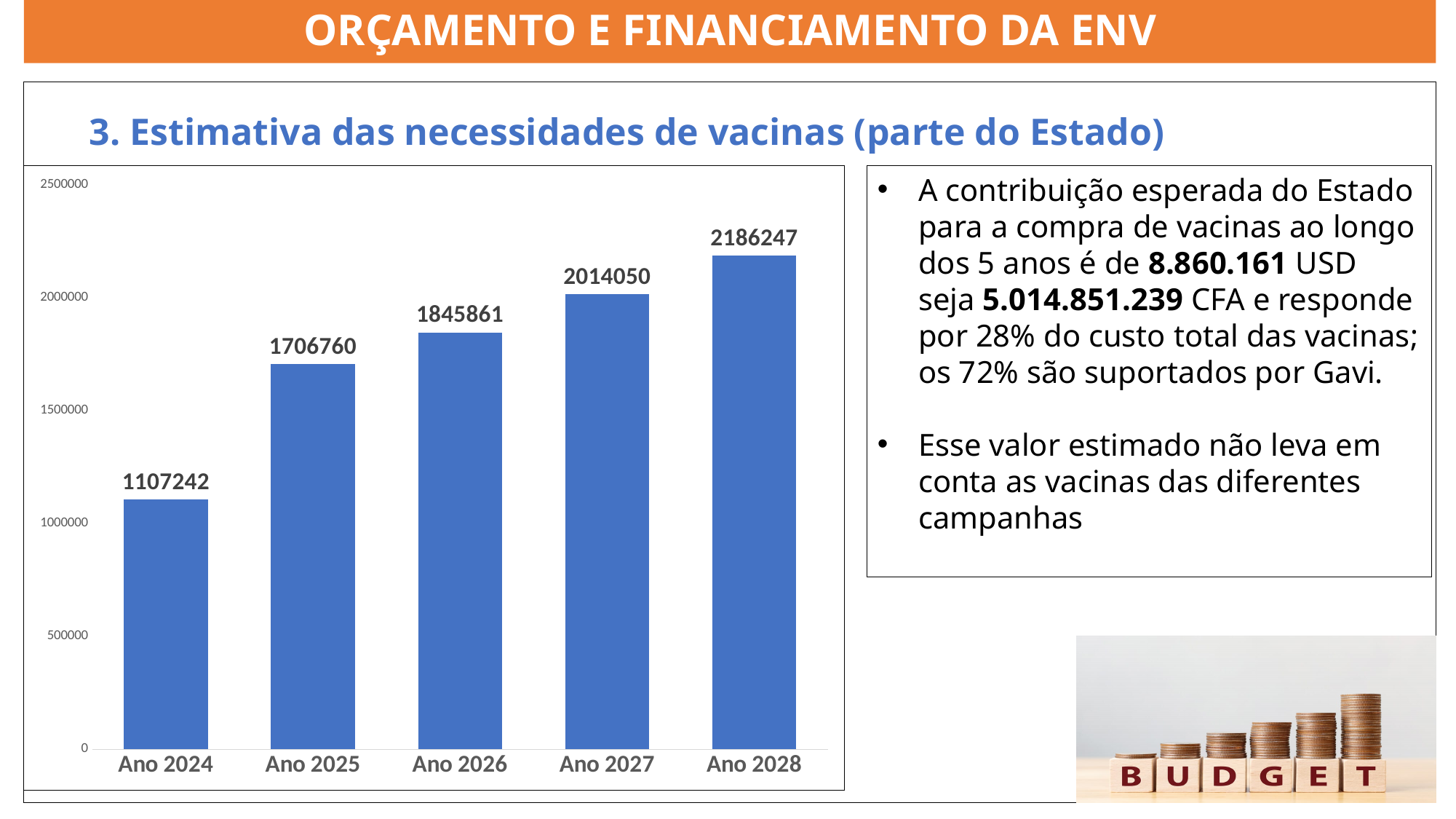
Which year has the highest value? Ano 2028 What is the value for Ano 2024? 1107242 How many years are shown on the x axis? 5 Which is larger, the value for Ano 2025 or the value for Ano 2026? Ano 2026 Is the value for Ano 2024 greater or less than 1000000? greater What is the value for Ano 2026? 1845861 What kind of chart is shown on the slide? bar chart What is the difference between the values for Ano 2027 and Ano 2026? 168189 Do the values rise or fall from Ano 2024 to Ano 2028? rise What is the difference between the values for Ano 2028 and Ano 2024? 1079005 What is the value for Ano 2027? 2014050 Which year has the lowest value? Ano 2024